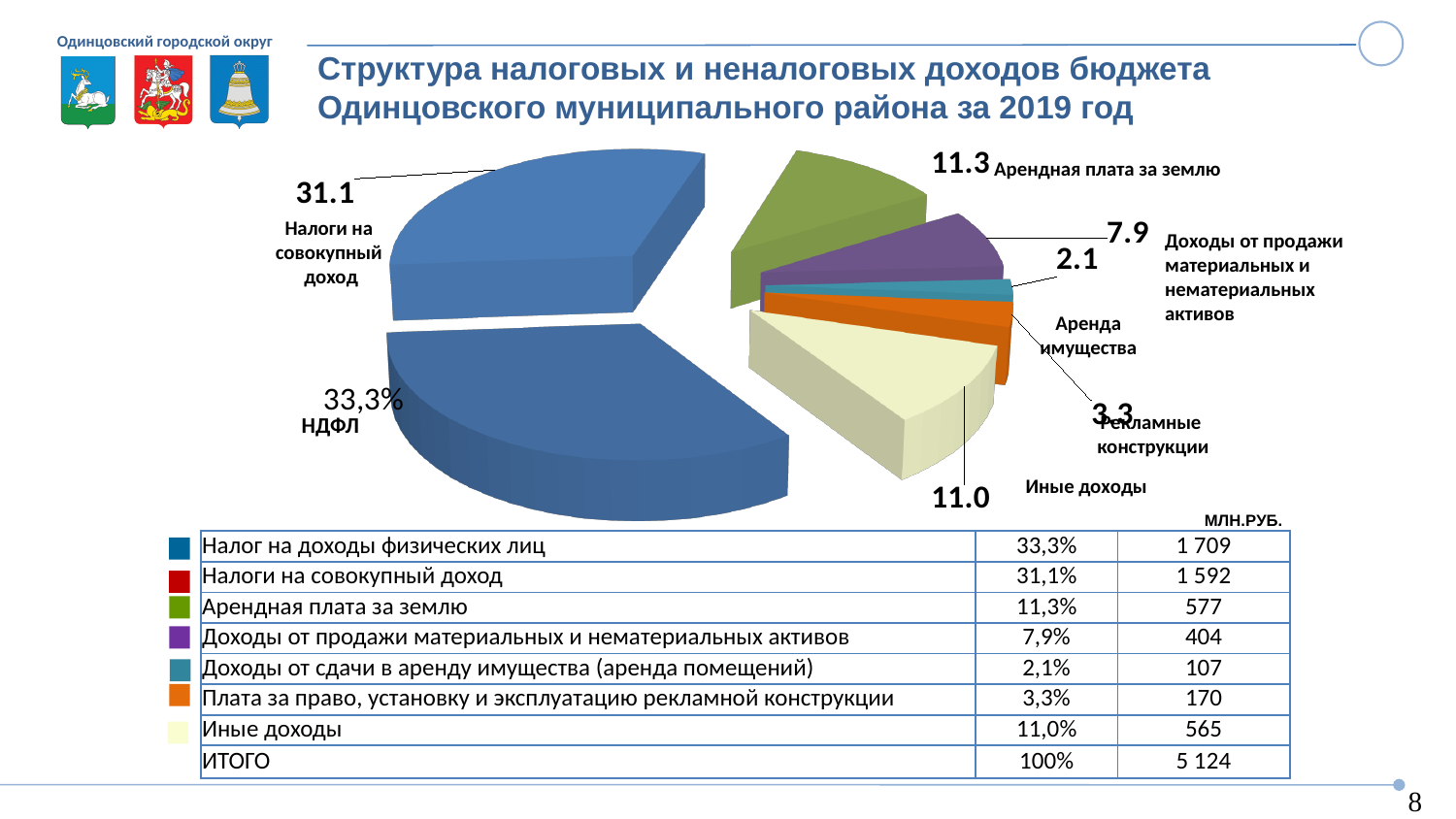
Which category has the smallest slice of the pie? Аренда имущества Which slice is larger: Арендная плата за землю or Иные доходы? Арендная плата за землю What value is labelled on the pie slice for Арендная плата за землю? 11.3 How many slices does the pie chart have? 7 What is the difference between the labelled values for НДФЛ and Налоги на совокупный доход, in percentage points? 2.2 What value is labelled on the pie slice for Аренда имущества? 2.1 According to the table, how many млн.руб. does Иные доходы amount to? 565 What value is labelled on the pie slice for Рекламные конструкции? 3.3 What kind of chart is shown on the slide? pie chart What value is labelled on the pie slice for НДФЛ? 33,3% What value is labelled on the pie slice for Налоги на совокупный доход? 31.1 Which category has the largest slice of the pie? НДФЛ